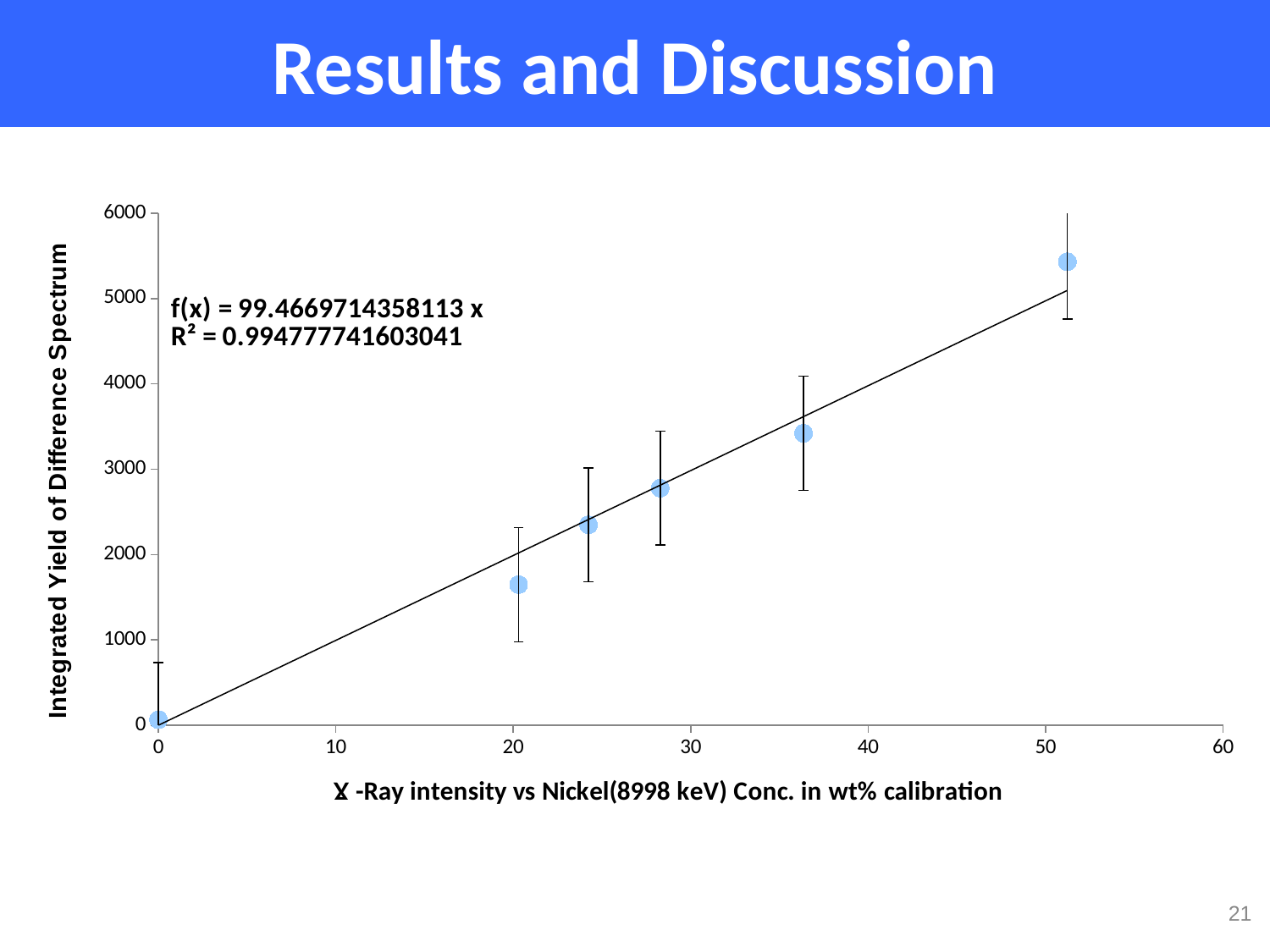
Is the value of the data point near x = 20 greater or less than 1000? greater Is the value of the data point near x = 28 greater or less than 3000? less What is the title of the y-axis? Integrated Yield of Difference Spectrum What kind of chart is shown on the slide? Scatter chart Do the plotted values rise or fall as the x-axis value increases? Rise How many data points are plotted on the chart? 6 Which data point has the lowest value on the chart? The point at x = 0 Which data point has the highest value on the chart? The rightmost point (near x = 51) Is the value of the data point near x = 36 greater or less than 3000? greater What is the R² value shown on the chart? 0.994777741603041